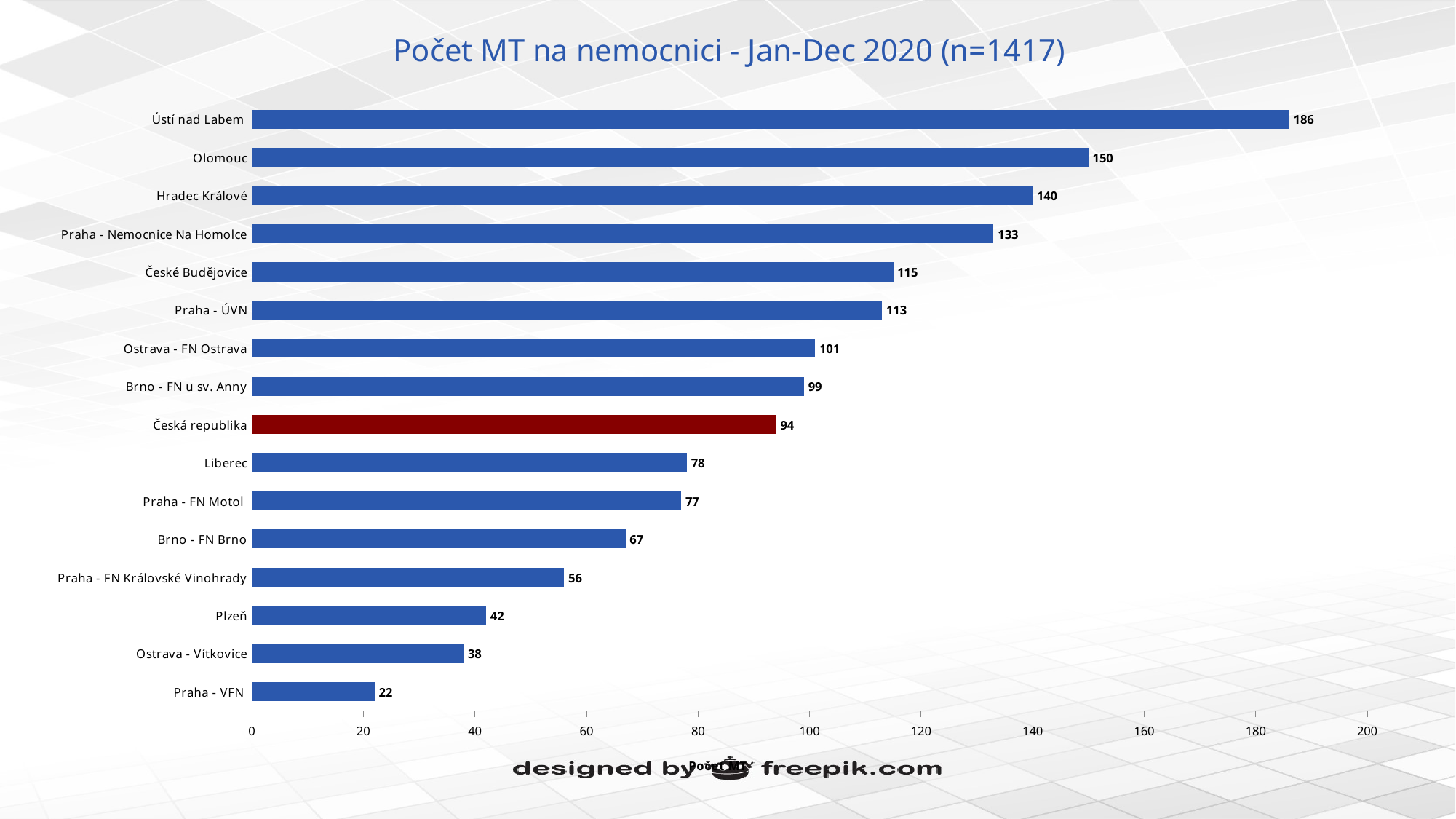
What is the difference between the values for Olomouc and Hradec Králové? 10 Which category has the highest value? Ústí nad Labem Which category's bar is coloured dark red instead of blue? Česká republika Which category has the lowest value? Praha - VFN What kind of chart is shown on the slide? bar chart What is the value for Česká republika? 94 How many categories are shown in the chart? 16 What is the value for Ústí nad Labem? 186 Which is larger, the value for Liberec or the value for Brno - FN Brno? Liberec Is the value for Praha - Nemocnice Na Homolce greater or less than 120? greater What is the title of the chart? Počet MT na nemocnici - Jan-Dec 2020 (n=1417) What is the value for Praha - FN Motol? 77